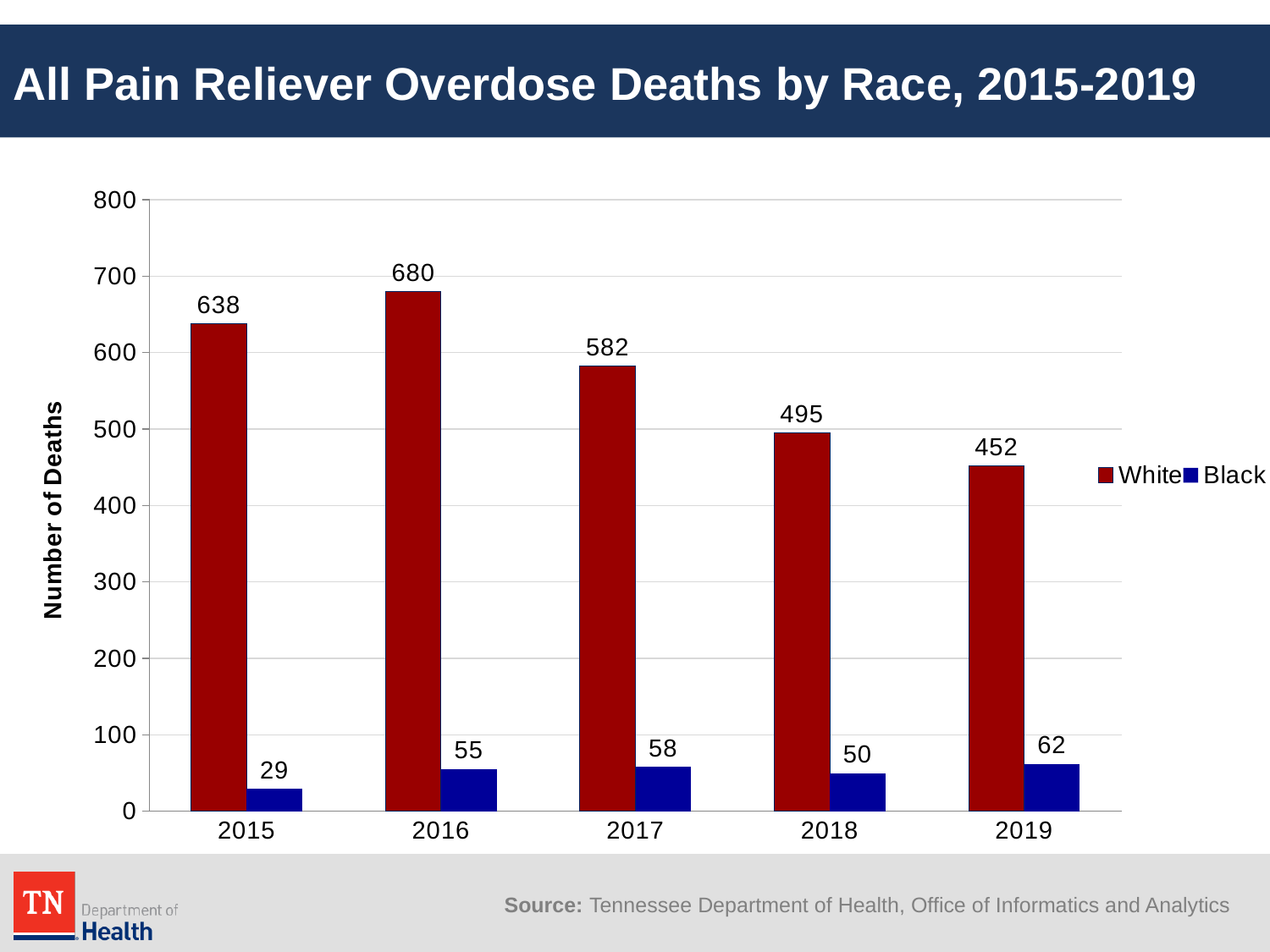
What is the number of pain reliever overdose deaths for White in 2016? 680 Do White pain reliever overdose deaths rise or fall from 2016 to 2019? Fall In which year were White pain reliever overdose deaths highest? 2016 Which is larger: Black deaths in 2017 or Black deaths in 2018? Black deaths in 2017 What is the number of pain reliever overdose deaths for Black in 2015? 29 How many series does the legend list? 2 What is the difference between White deaths in 2016 and White deaths in 2019? 228 How many years are shown on the x axis? 5 What is the number of pain reliever overdose deaths for White in 2019? 452 In which year were Black pain reliever overdose deaths lowest? 2015 What kind of chart is shown on the slide? Bar chart Is the value for White in 2018 greater or less than 400? greater